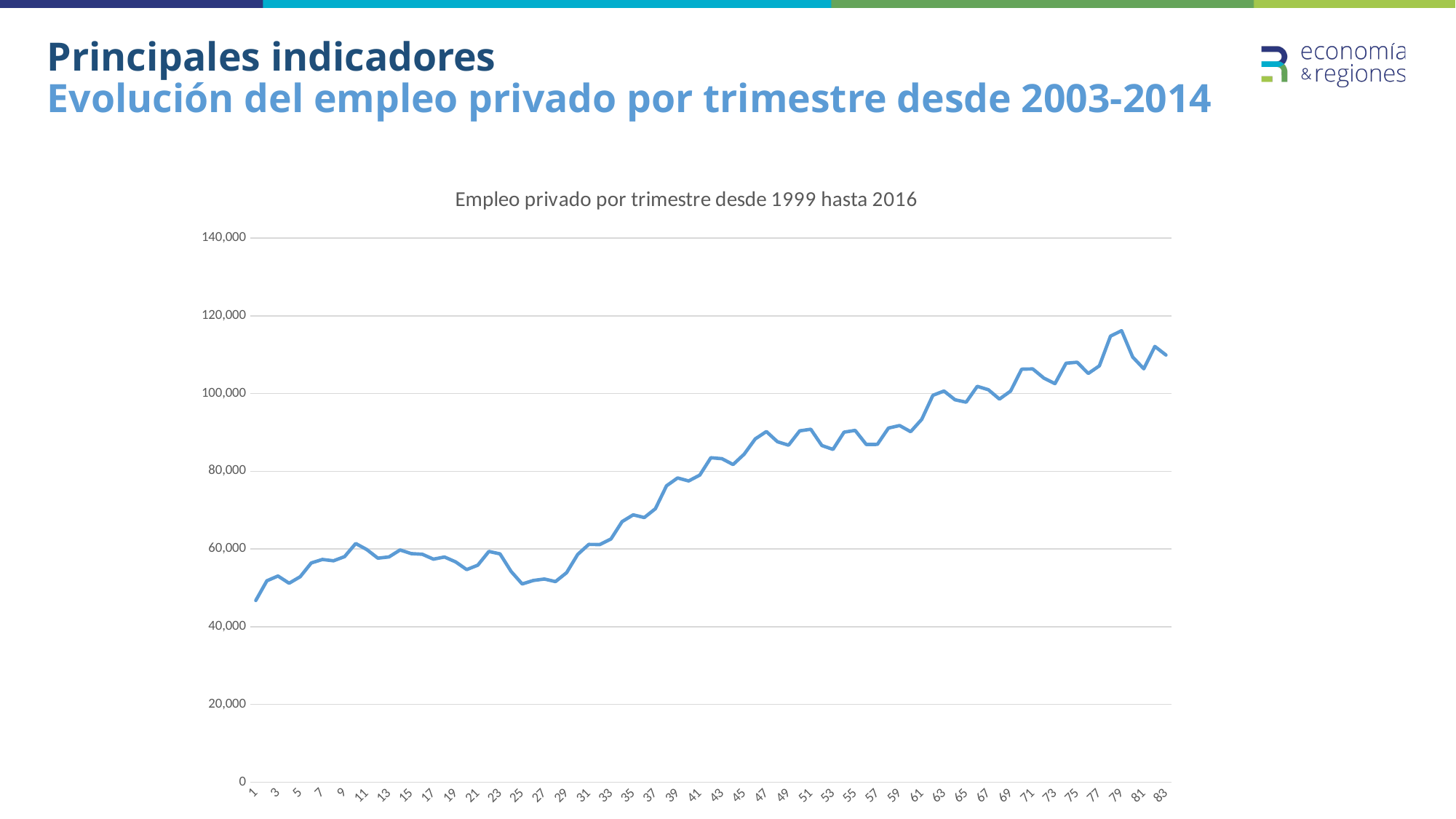
What is the highest value shown on the y axis? 140,000 What is the title of the chart? Empleo privado por trimestre desde 1999 hasta 2016 Which is larger, the value at point 1 or the value at point 83? point 83 Overall, do the values rise or fall from left to right along the x axis? rise Is the value at point 47 greater or less than 80,000? greater Which is larger, the value at point 11 or the value at point 25? point 11 Is the value at point 79 greater or less than 120,000? less What kind of chart is shown on the slide? line chart Is the value at point 79 greater or less than 100,000? greater